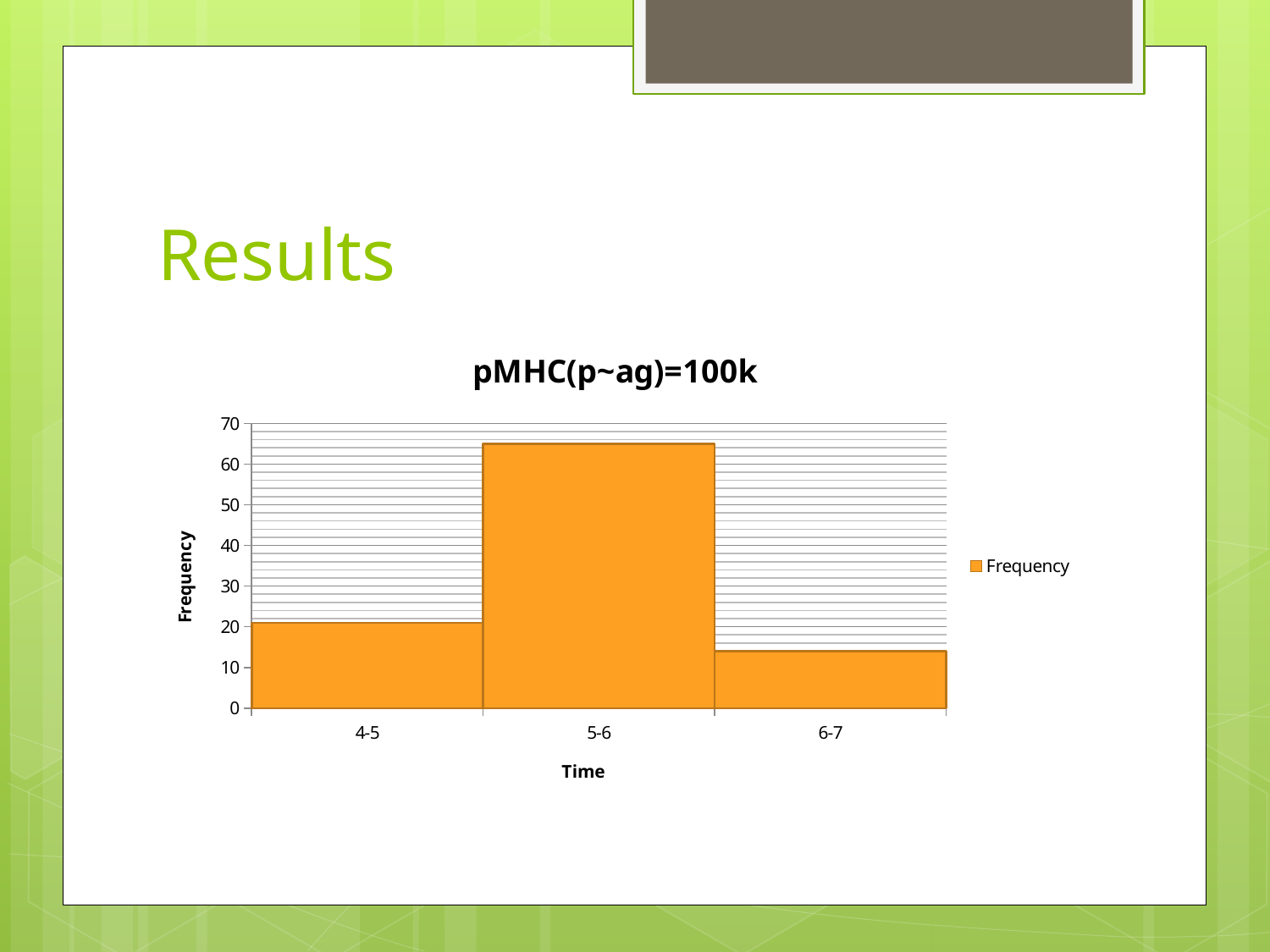
How many categories are shown on the x axis of the chart? 3 Is the frequency for 4-5 greater or less than 30? less What is the label of the y axis of the chart? Frequency Which has a larger frequency, 4-5 or 6-7? 4-5 Which time category has the lowest frequency? 6-7 Is the frequency for 6-7 greater or less than 20? less Is the frequency for 6-7 greater or less than 10? greater How many series does the chart's legend list? 1 What kind of chart is shown on the slide? bar chart Which time category has the highest frequency? 5-6 What is the title of the chart? pMHC(p~ag)=100k